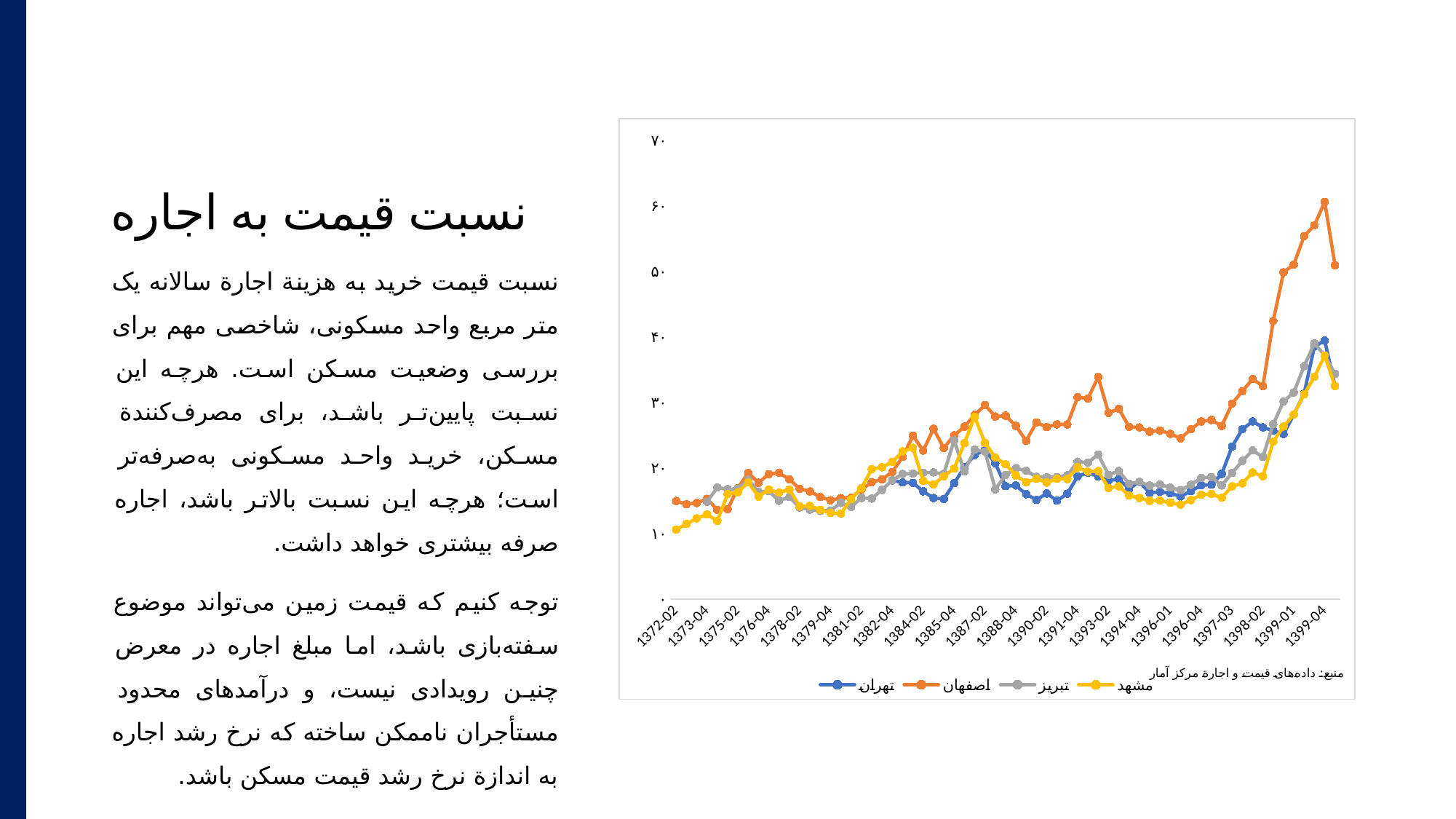
Which series reaches the highest value on the chart? اصفهان Which series has the lowest value at 1372-02? مشهد Overall, does the اصفهان series rise or fall from the left of the x axis to the right? rise Is the value for مشهد at 1372-02 greater or less than 20? less Is the peak value of the اصفهان series greater or less than 50? greater What source is cited below the chart? منبع: داده‌های قیمت و اجارة مرکز آمار Which series are listed in the legend? تهران, اصفهان, تبریز, مشهد Is the value for اصفهان at 1399-04 greater or less than 40? greater What kind of chart is shown on the slide? line chart How many series does the legend list? 4 At the last point on the x axis (1399-04), which is higher, اصفهان or مشهد? اصفهان